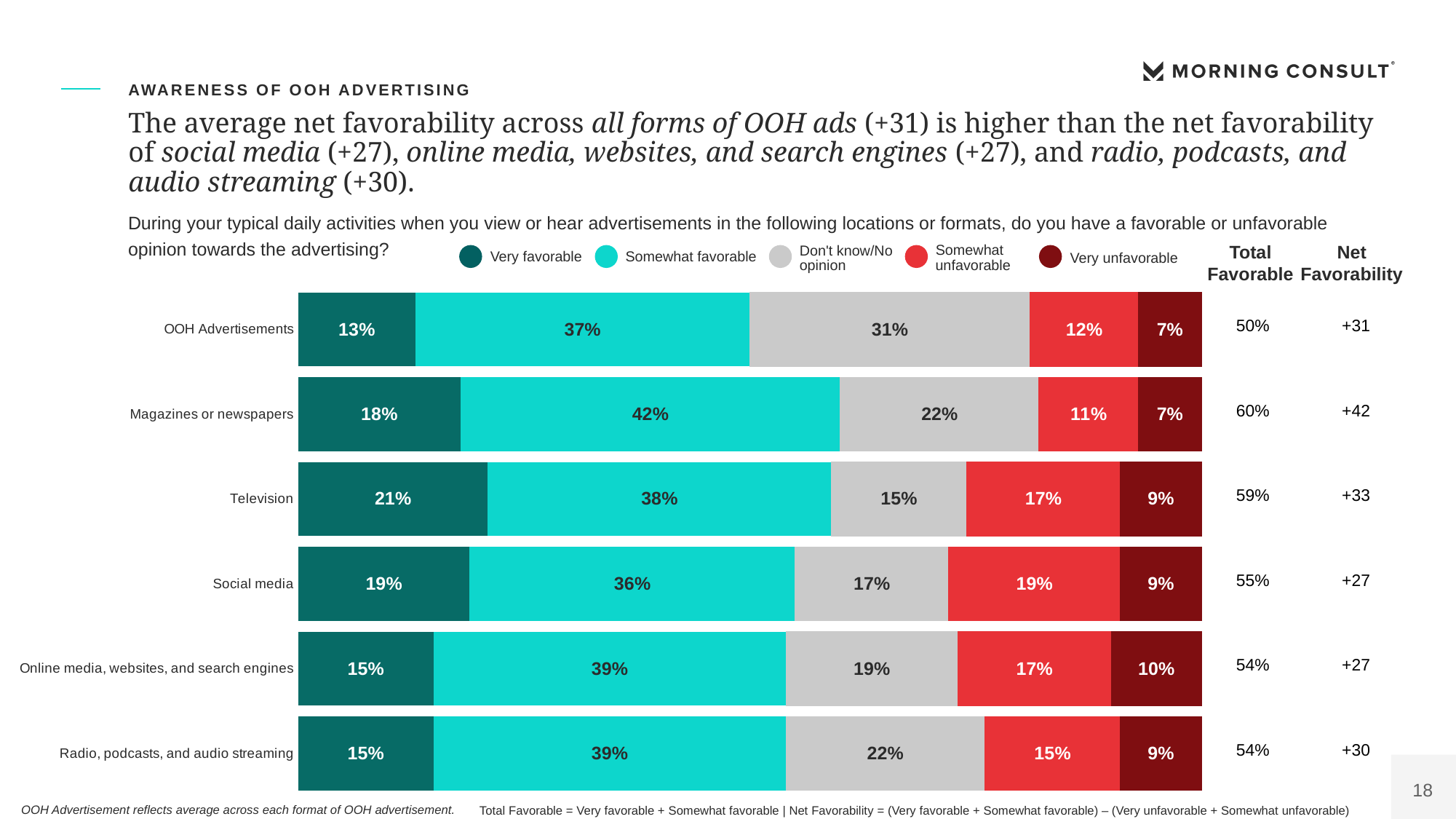
How many series does the legend list? 5 What is the "Very unfavorable" value for Online media, websites, and search engines? 10% What is the "Somewhat favorable" value for Magazines or newspapers? 42% What is the total of the "Very favorable" and "Somewhat favorable" segments for Radio, podcasts, and audio streaming? 54% What kind of chart is shown on the slide? Stacked bar chart How many categories are shown in the chart? 6 Which category has the lowest "Very favorable" percentage? OOH Advertisements What percentage of respondents are "Very favorable" toward Television advertising? 21% Which category has the highest "Very favorable" percentage? Television Which is larger, the "Don't know/No opinion" value for Magazines or newspapers or for Television? Magazines or newspapers What is the "Don't know/No opinion" value for OOH Advertisements? 31% What is the difference between the "Somewhat unfavorable" values for Social media and OOH Advertisements? 7%